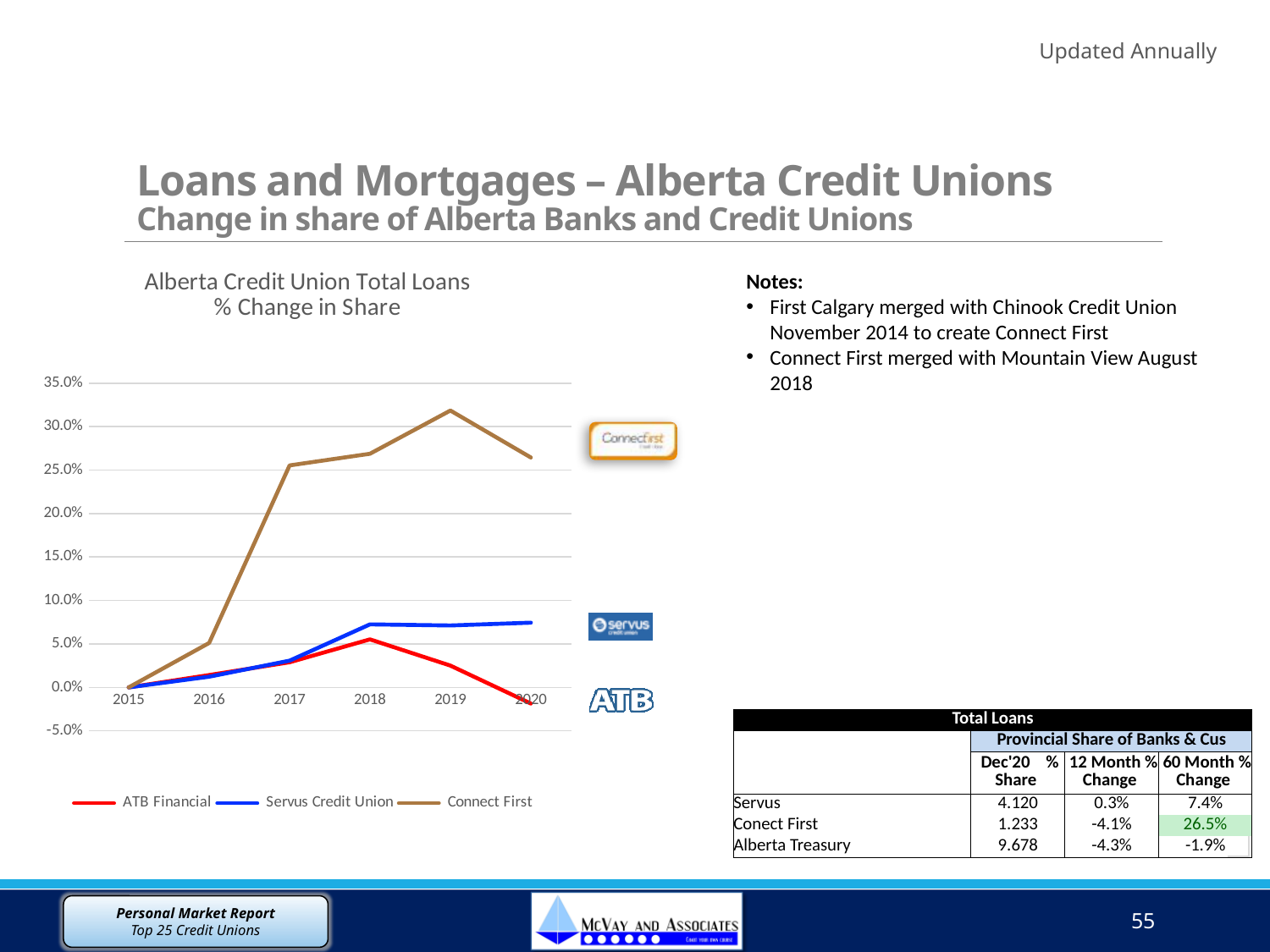
Is the value for Servus Credit Union in 2020 greater or less than 5.0%? greater How many series does the chart legend list? 3 What kind of chart is shown on the slide? Line chart Which series has the lowest value in 2020? ATB Financial Is the value for Connect First in 2018 greater or less than 25.0%? greater Does the Connect First line rise or fall from 2015 to 2019? Rise Is the value for ATB Financial in 2020 greater or less than 0.0%? less How many years are plotted along the x axis of the chart? 6 In 2019, which is larger: the value for Servus Credit Union or the value for ATB Financial? Servus Credit Union What is the title of the chart? Alberta Credit Union Total Loans % Change in Share Which series has the highest value in 2020? Connect First